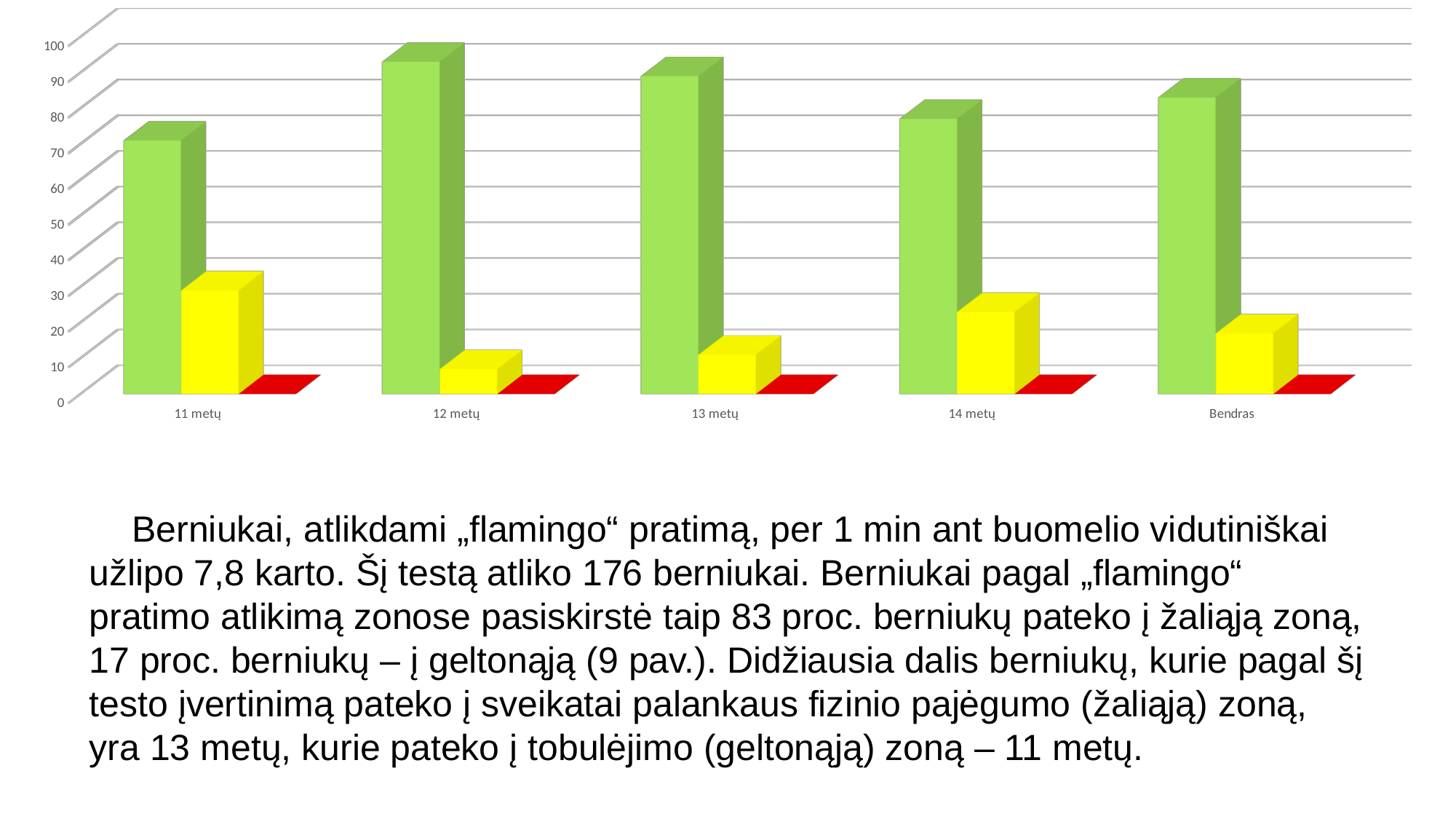
Is the yellow bar for 12 metų greater or less than 20? less What kind of chart is shown on the slide? bar chart What is the highest value shown on the vertical axis of the chart? 100 Is the yellow bar for 11 metų greater or less than 20? greater Is the green bar for 11 metų greater or less than 60? greater Which category has the shortest green bar? 11 metų How many categories are shown on the x axis of the chart? 5 Which category has the tallest green bar? 12 metų Which category has the shortest yellow bar? 12 metų Which is larger, the green bar for 12 metų or the green bar for 14 metų? 12 metų Which category has the tallest yellow bar? 11 metų